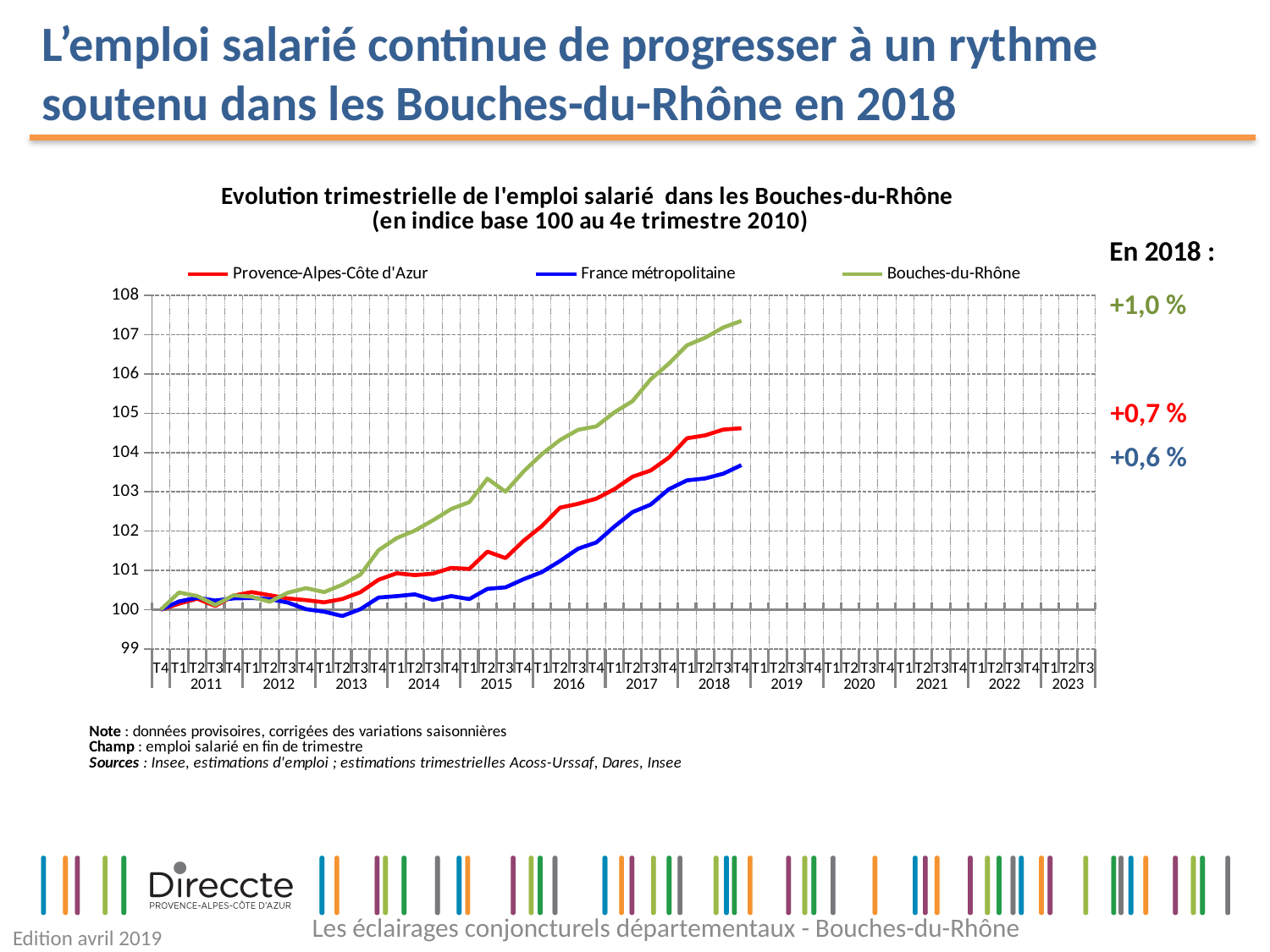
How many series does the legend of the chart list? 3 Is the value for Provence-Alpes-Côte d'Azur at T4 2018 greater or less than 104? greater Which series is plotted in green on the chart? Bouches-du-Rhône What is the title of the chart? Evolution trimestrielle de l'emploi salarié dans les Bouches-du-Rhône (en indice base 100 au 4e trimestre 2010) What kind of chart is shown on the slide? line chart Which series has the lowest index value at the end of 2018? France métropolitaine According to the annotation on the slide, what was the 2018 change in salaried employment for Bouches-du-Rhône? +1,0 % At T4 2018, which is larger: the value for Provence-Alpes-Côte d'Azur or for France métropolitaine? Provence-Alpes-Côte d'Azur Is the value for France métropolitaine at T4 2018 greater or less than 104? less Do the index values for Bouches-du-Rhône rise or fall between 2013 and 2018? rise Which series has the highest index value at the end of 2018? Bouches-du-Rhône Is the value for Bouches-du-Rhône at T4 2018 greater or less than 106? greater